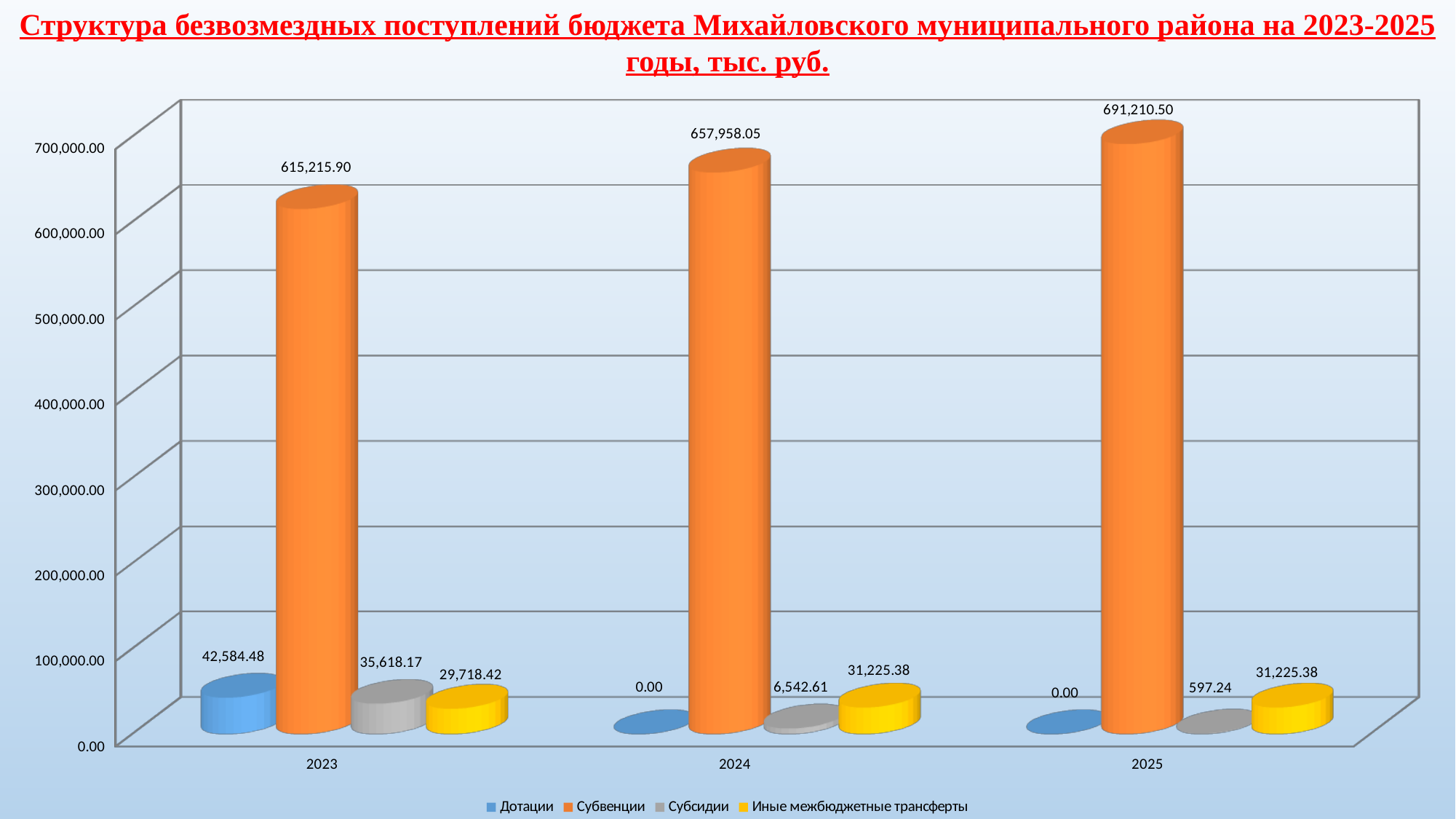
Do the values of Субвенции rise or fall from 2023 to 2025? rise In which year is Субсидии lowest? 2025 Which is larger in 2023: Субсидии or Иные межбюджетные трансферты? Субсидии What is the value of Субвенции for 2023? 615,215.90 What is the value of Субсидии for 2025? 597.24 What is the difference between Субвенции in 2025 and in 2023? 75,994.60 What is the value of Дотации for 2025? 0.00 What is the value of Дотации for 2023? 42,584.48 What is the value of Иные межбюджетные трансферты for 2024? 31,225.38 In which year is Субвенции highest? 2025 What is the difference between Субсидии in 2023 and in 2024? 29,075.56 How many series does the legend list? 4